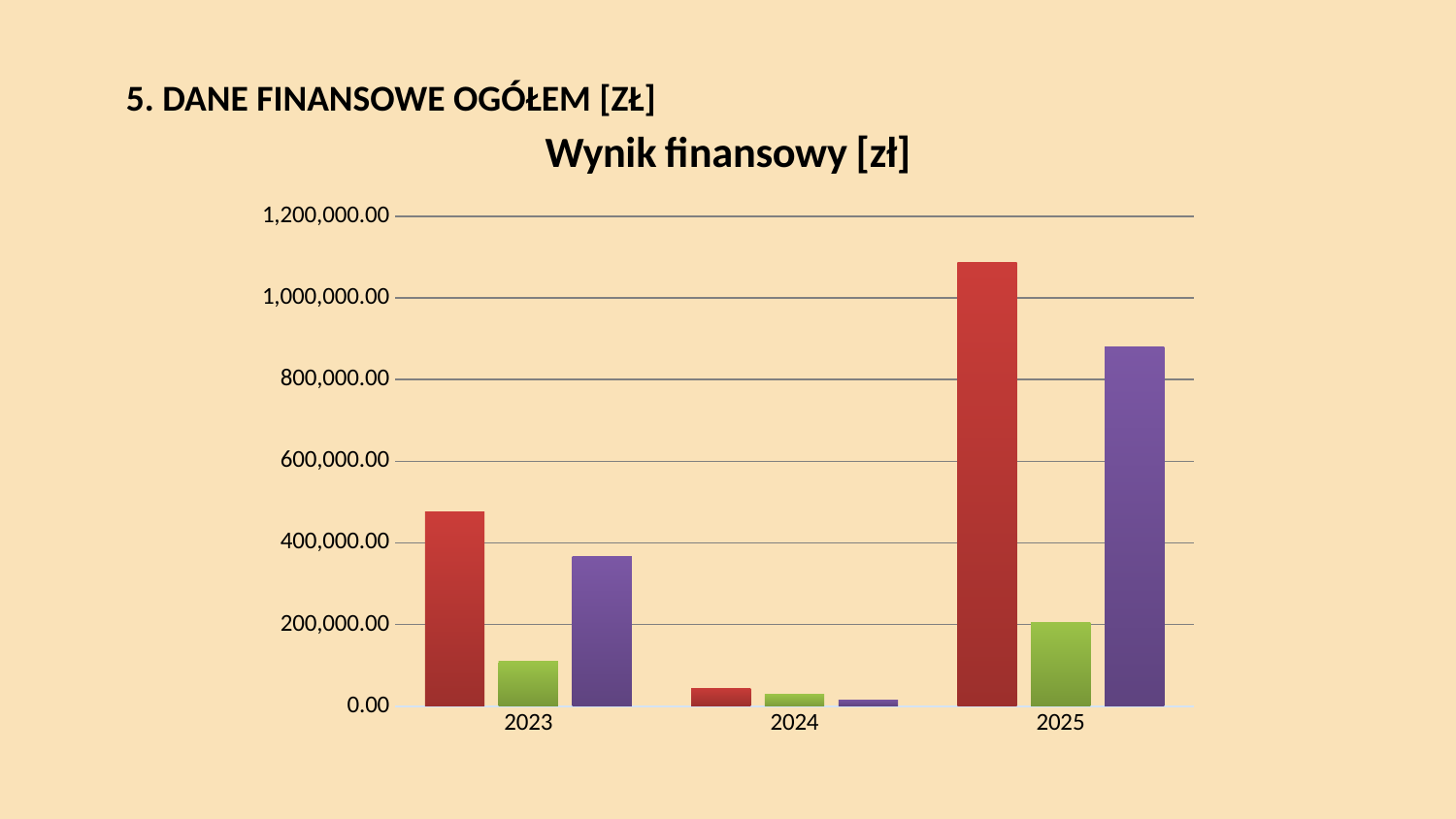
Is the value of the purple bar for 2025 greater or less than 800,000.00? greater Is the value of the red bar for 2025 greater or less than 1,000,000.00? greater What is the title of the chart? Wynik finansowy [zł] Which year has the shortest purple bar? 2024 Is the value of the green bar for 2023 greater or less than 200,000.00? less What kind of chart is shown on the slide? bar chart How many categories are shown on the x axis of the chart? 3 Which is larger, the red bar for 2023 or the red bar for 2024? the red bar for 2023 Which is larger, the green bar for 2025 or the purple bar for 2025? the purple bar for 2025 Which year has the tallest red bar? 2025